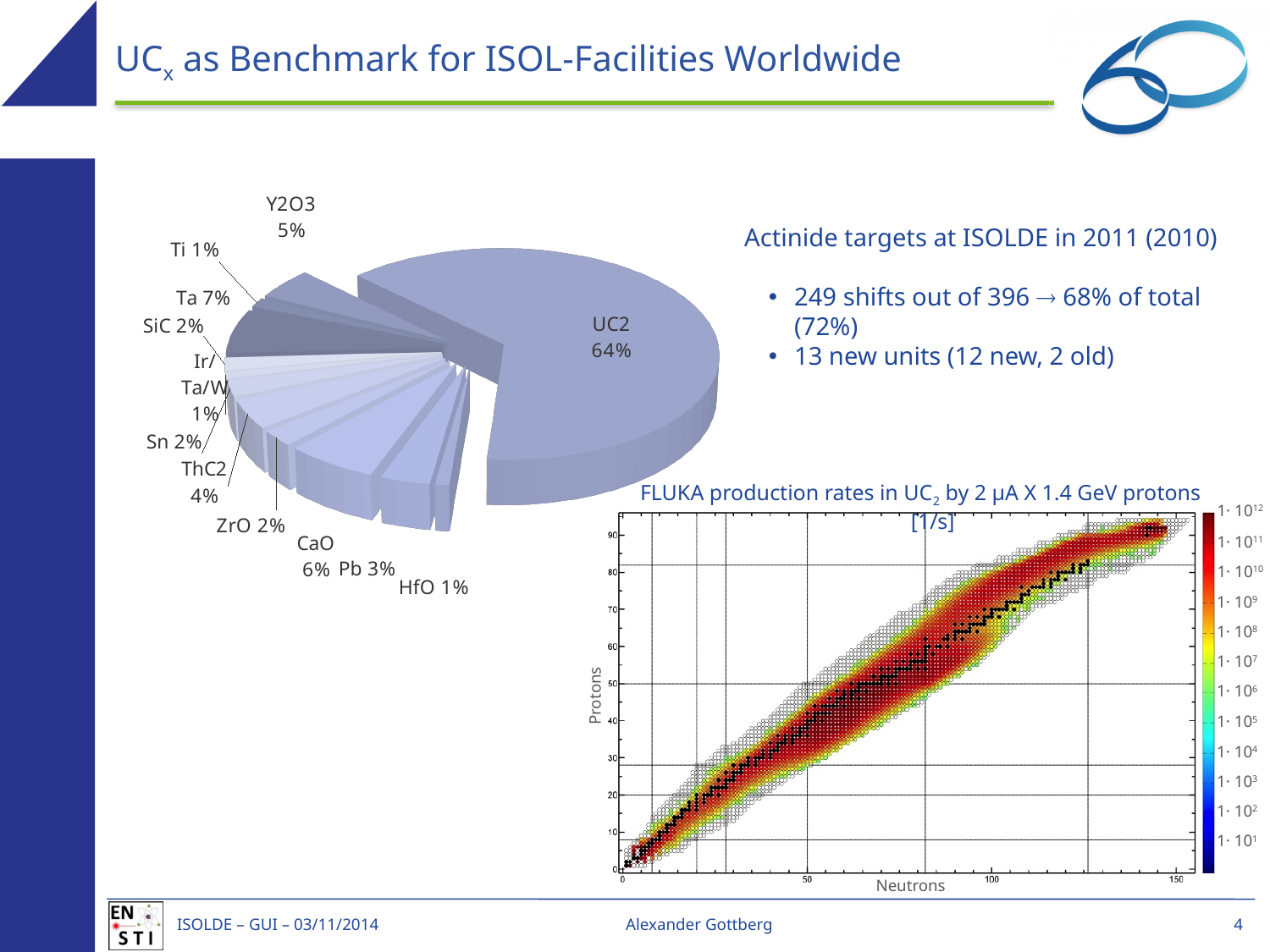
In the pie chart, which is larger, Ta or CaO? Ta In the pie chart, what is the value shown for Y2O3? 5% How many labelled slices does the pie chart have? 12 In the pie chart, which category has the largest slice? UC2 What are the axis labels of the FLUKA production rates chart at the bottom right? Protons (y axis) and Neutrons (x axis) In the pie chart, what is the value shown for Ta? 7% In the pie chart, what is the value shown for Pb? 3% In the pie chart, what is the value shown for CaO? 6% In the pie chart, what share does UC2 have? 64% In the pie chart, what is the difference in percentage points between UC2 and Ta? 57 What kind of chart is shown on the left of the slide? Pie chart In the pie chart, what is the value shown for ThC2? 4%